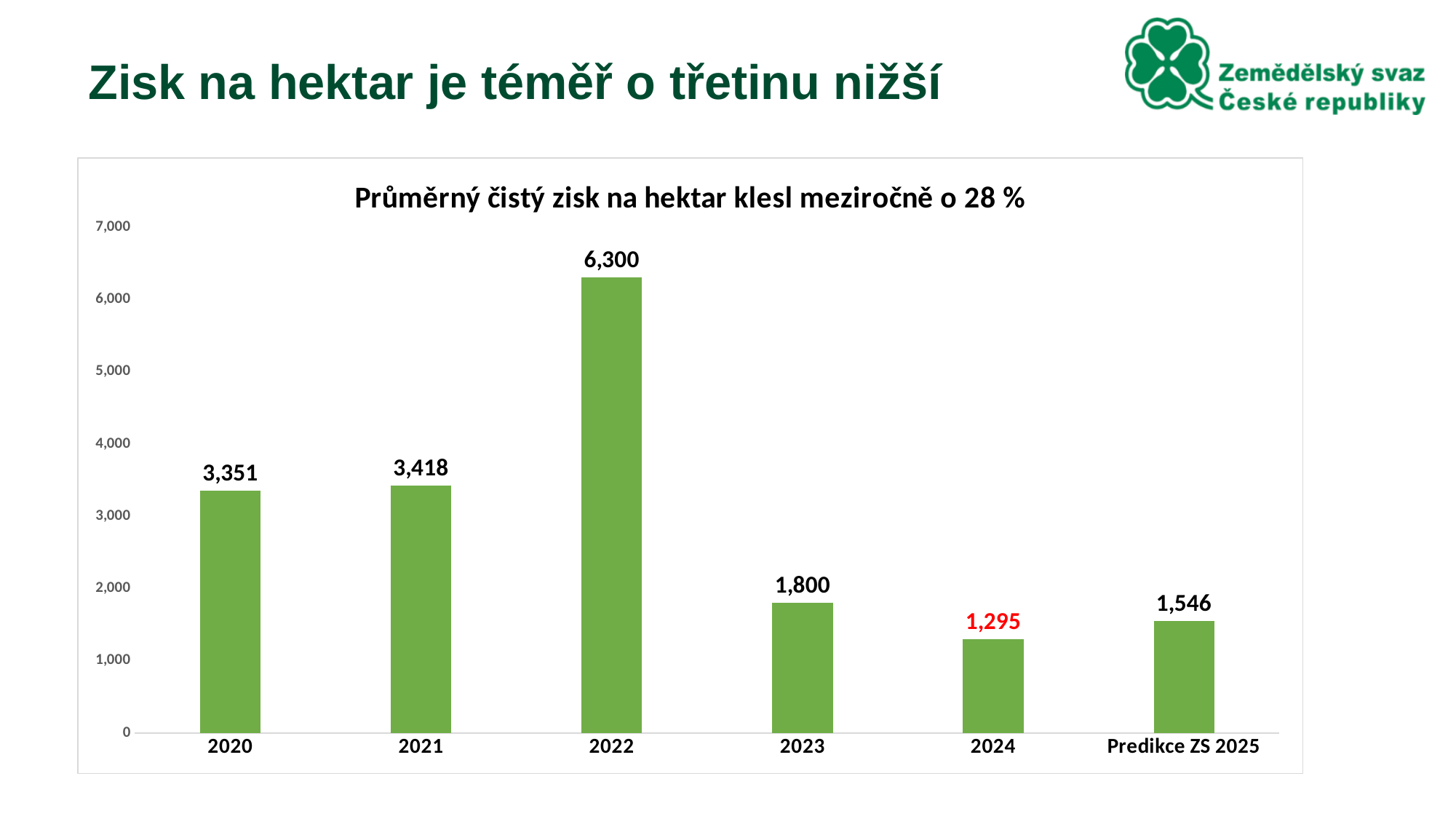
What is the value for Predikce ZS 2025? 1,546 What is the difference between the values for 2021 and 2020? 67 Is the value for 2023 greater or less than 2,000? less What is the title of the chart? Průměrný čistý zisk na hektar klesl meziročně o 28 % What is the value for 2022? 6,300 What is the value for 2024? 1,295 Which category has the lowest value? 2024 How many categories are shown on the x axis? 6 What kind of chart is shown on the slide? bar chart What is the difference between the values for 2023 and 2024? 505 Which is larger, the value for 2020 or the value for 2021? 2021 Which year has the highest value? 2022